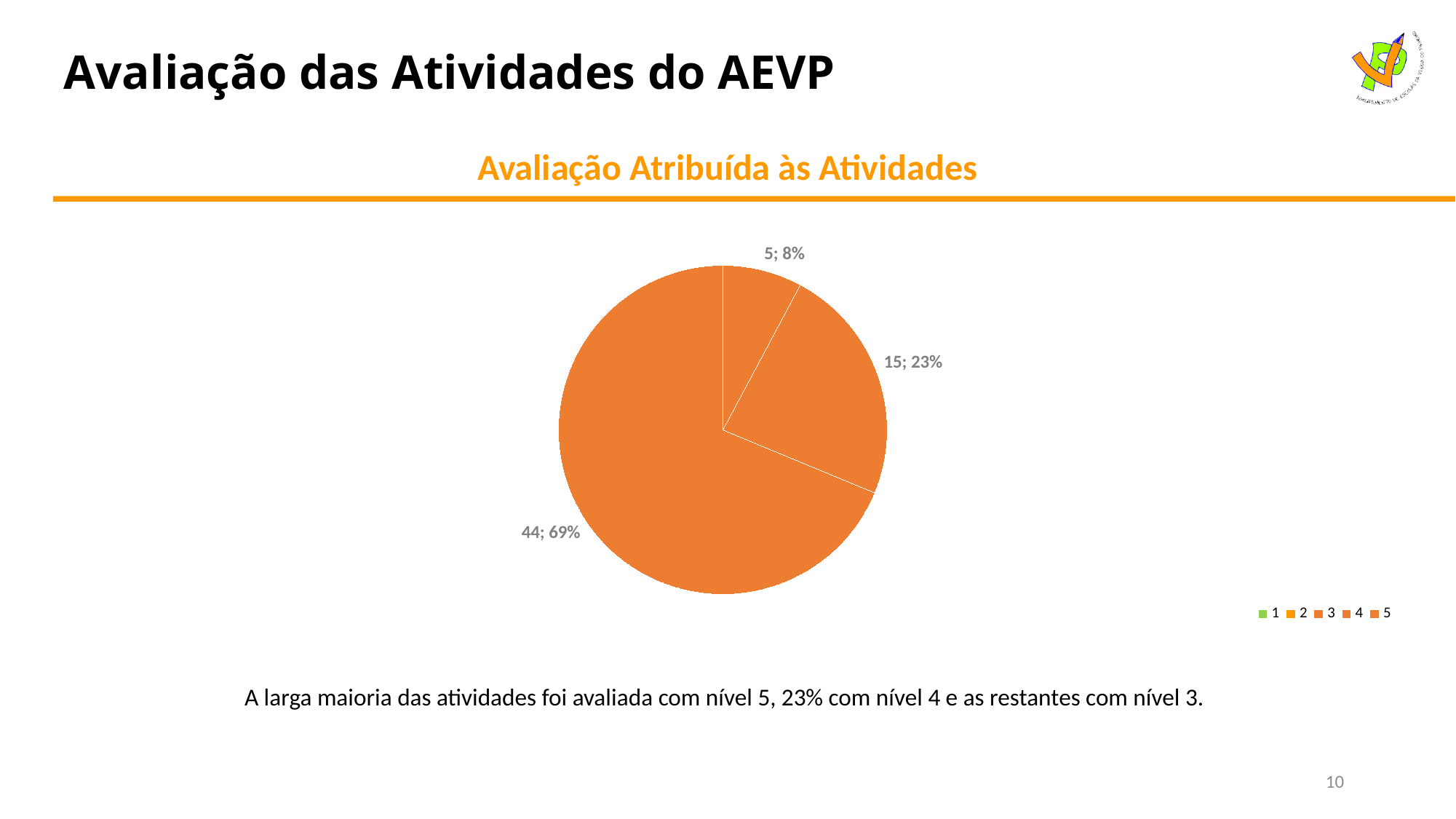
What is the data label of the smallest slice of the pie chart? 5; 8% What is the difference in count between the largest slice (44) and the slice with 15? 29 What kind of chart is shown on the slide? pie chart What percentage share of the pie corresponds to the slice with 15 activities? 23% How many entries does the chart legend list? 5 What percentage share of the pie corresponds to the slice with 44 activities? 69% What is the title of the chart? Avaliação Atribuída às Atividades What is the difference in percentage points between the 69% slice and the 8% slice? 61 What is the total count across all three labelled slices of the pie chart? 64 What is the data label of the largest slice of the pie chart? 44; 69% How many slices with data labels are visible in the pie chart? 3 Which slice is larger: the one labelled 15; 23% or the one labelled 5; 8%? 15; 23%